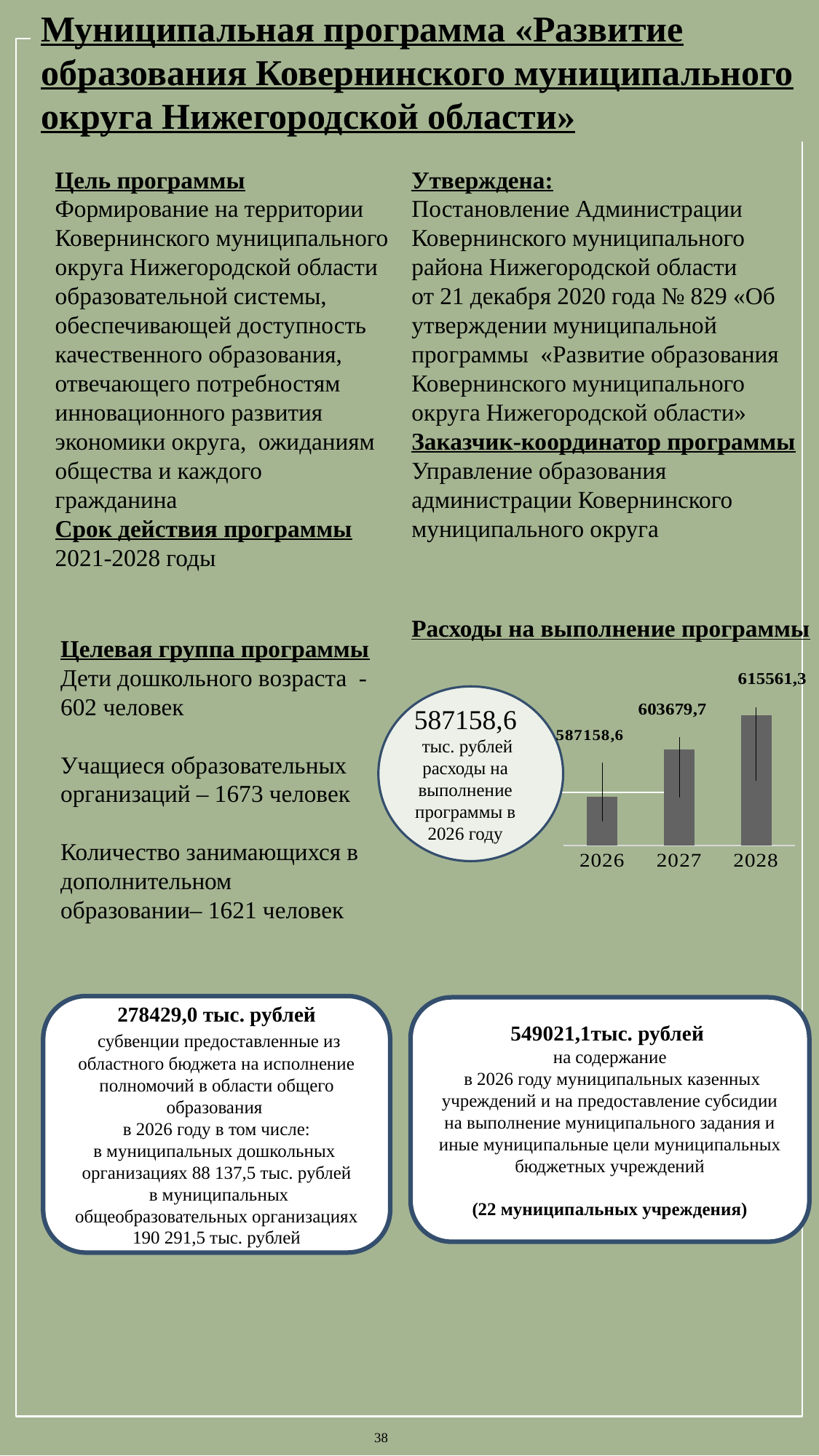
What is the value for 2028 in the chart? 615561,3 What kind of chart is shown on the slide? bar chart What is the value for 2027 in the chart? 603679,7 What is the difference between the values for 2028 and 2026? 28402,7 What is the value for 2026 in the chart? 587158,6 Which year has the lowest value in the chart? 2026 What is the difference between the values for 2027 and 2026? 16521,1 Which is larger, the value for 2027 or the value for 2028? 2028 How many years are shown in the chart? 3 What is the difference between the values for 2028 and 2027? 11881,6 Do the values rise or fall from 2026 to 2028? rise Which year has the highest value in the chart? 2028